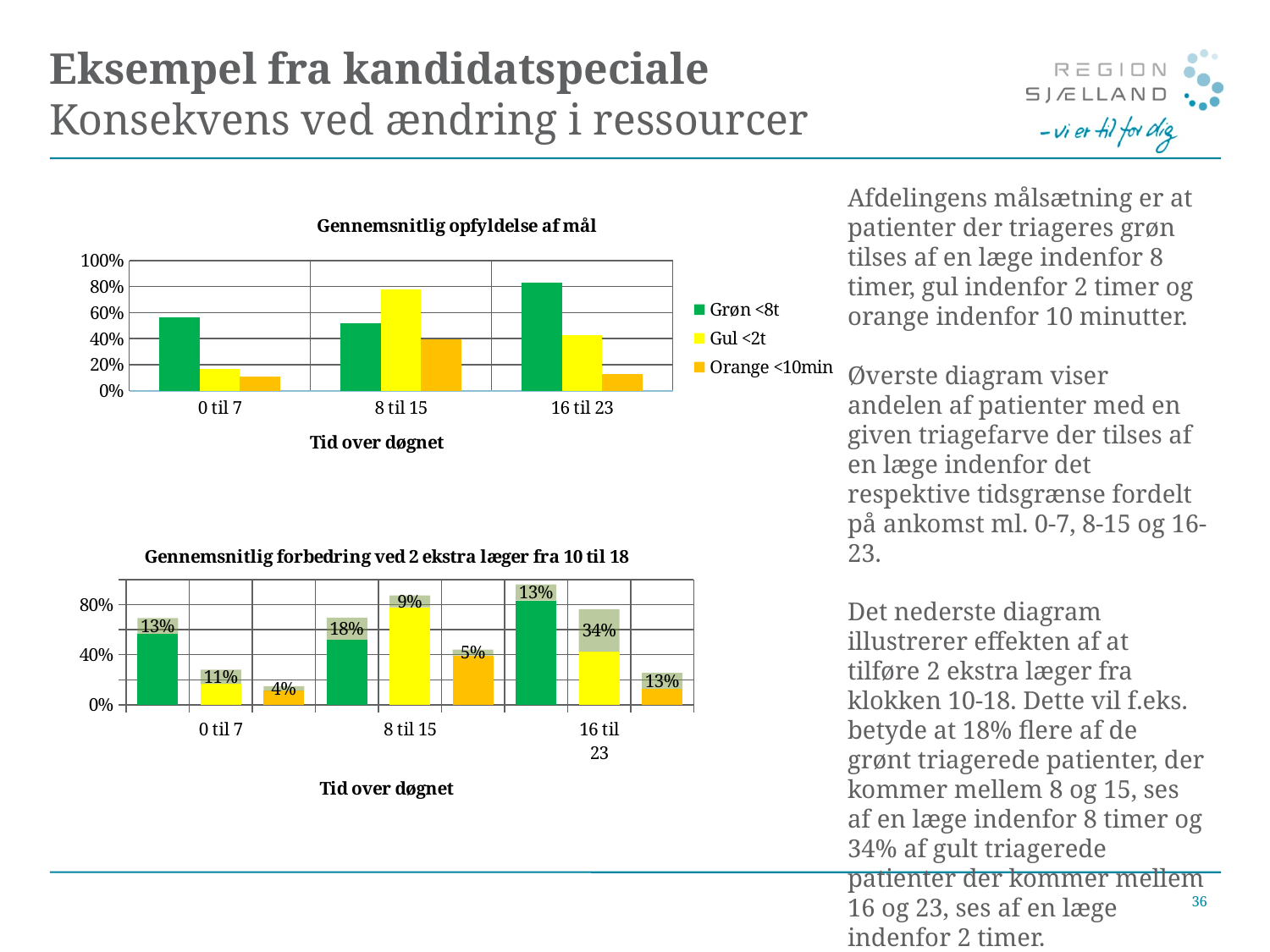
In the bottom chart, what is the difference between the labelled improvement for the green bar in 8 til 15 (18%) and in 0 til 7 (13%)? 5% In the top chart, is the value for Orange <10min in the 0 til 7 category greater or less than 20%? less In the top chart, which category has the highest value for Grøn <8t? 16 til 23 What is the title of the bottom chart? Gennemsnitlig forbedring ved 2 ekstra læger fra 10 til 18 What kind of chart is the top chart titled "Gennemsnitlig opfyldelse af mål"? bar chart How many time-of-day categories are shown on the x axis of the top chart? 3 How many series does the legend of the top chart list? 3 In the top chart, which series has the lowest value in the 0 til 7 category? Orange <10min In the top chart, is the value for Gul <2t in the 8 til 15 category greater or less than 60%? greater In the top chart, which category has the highest value for Gul <2t? 8 til 15 In the bottom chart, what improvement is labelled for the yellow bar in the 16 til 23 category? 34% In the bottom chart, what improvement is labelled for the green bar in the 8 til 15 category? 18%